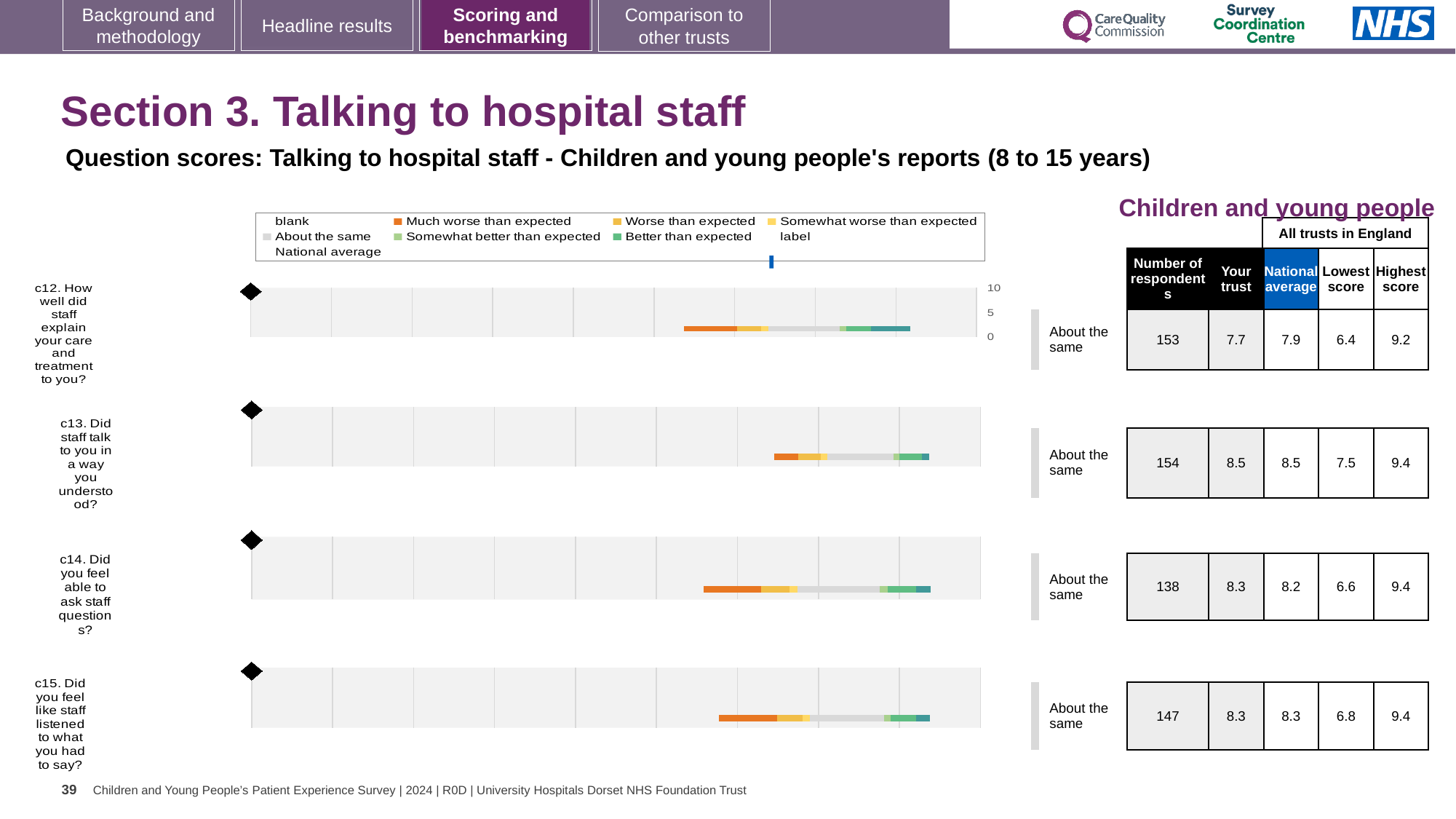
What is the national average score for c14 (Did you feel able to ask staff questions?)? 8.2 What kind of chart is used for each question on the slide? bar chart How many survey questions (c12 to c15) are charted on the slide? 4 How many respondents answered c13 (Did staff talk to you in a way you understood?)? 154 What is the 'Your trust' score for c12 (How well did staff explain your care and treatment to you?)? 7.7 What is the lowest score among all trusts in England for c15 (Did you feel like staff listened to what you had to say?)? 6.8 What benchmark category is shown for all four questions on the slide? About the same What is the maximum value shown on the score axis of the charts? 10 Which question has the lowest 'Your trust' score? c12 For c12, what is the difference between the highest score (9.2) and the lowest score (6.4) among all trusts in England? 2.8 Which question has the highest 'Your trust' score? c13 For c14, which is larger: the 'Your trust' score or the national average? Your trust